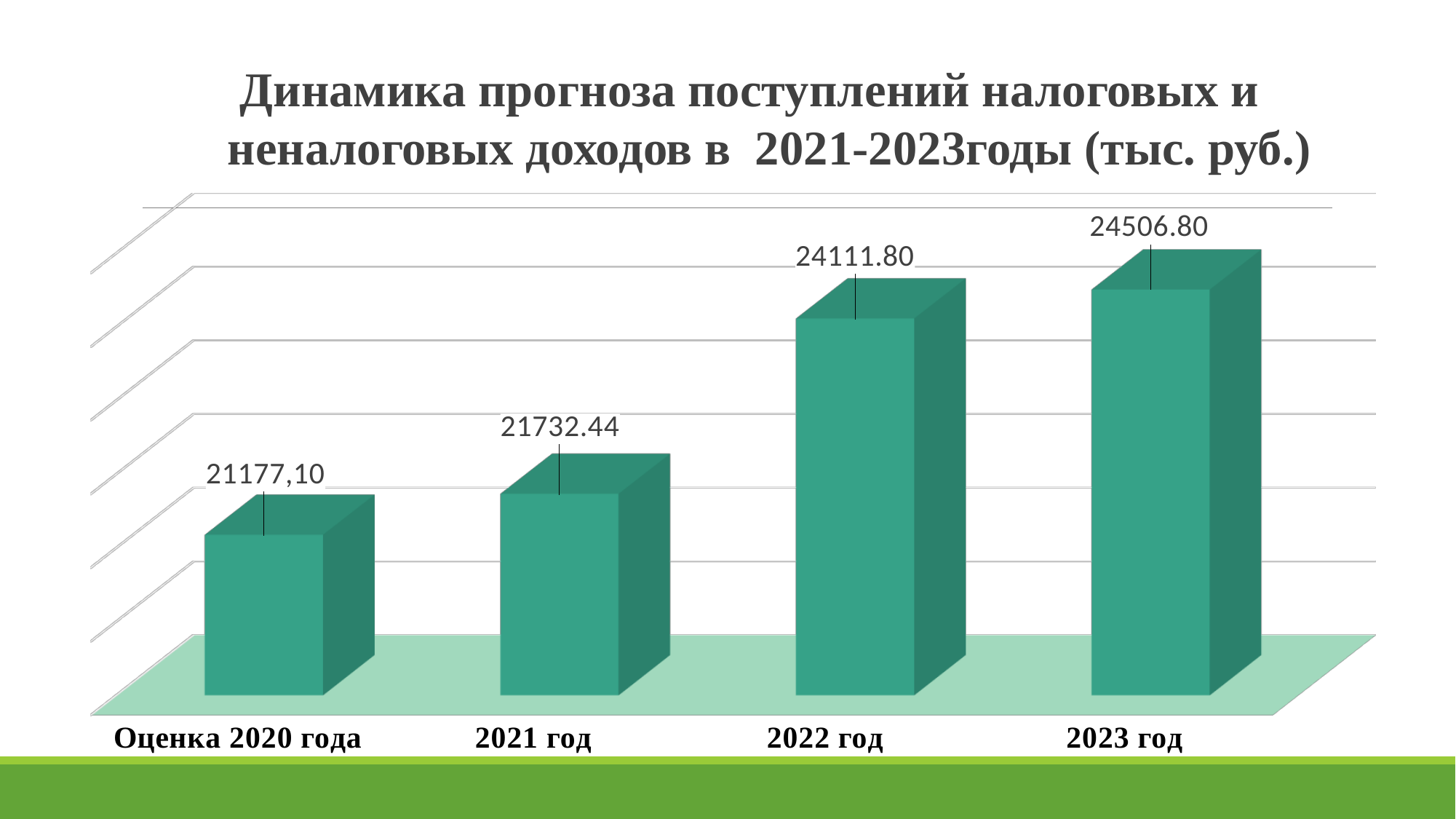
What is the difference between the values for 2022 год and 2021 год? 2379.36 What is the value for Оценка 2020 года? 21177,10 Which is larger, the value for 2021 год or the value for 2022 год? 2022 год What is the value for 2021 год? 21732.44 What is the difference between the values for 2023 год and 2022 год? 395.00 What is the value for 2022 год? 24111.80 What is the value for 2023 год? 24506.80 Which category has the highest value? 2023 год Do the values rise or fall from Оценка 2020 года to 2023 год? Rise What kind of chart is shown on the slide? Bar chart How many categories are shown on the chart? 4 Which category has the lowest value? Оценка 2020 года